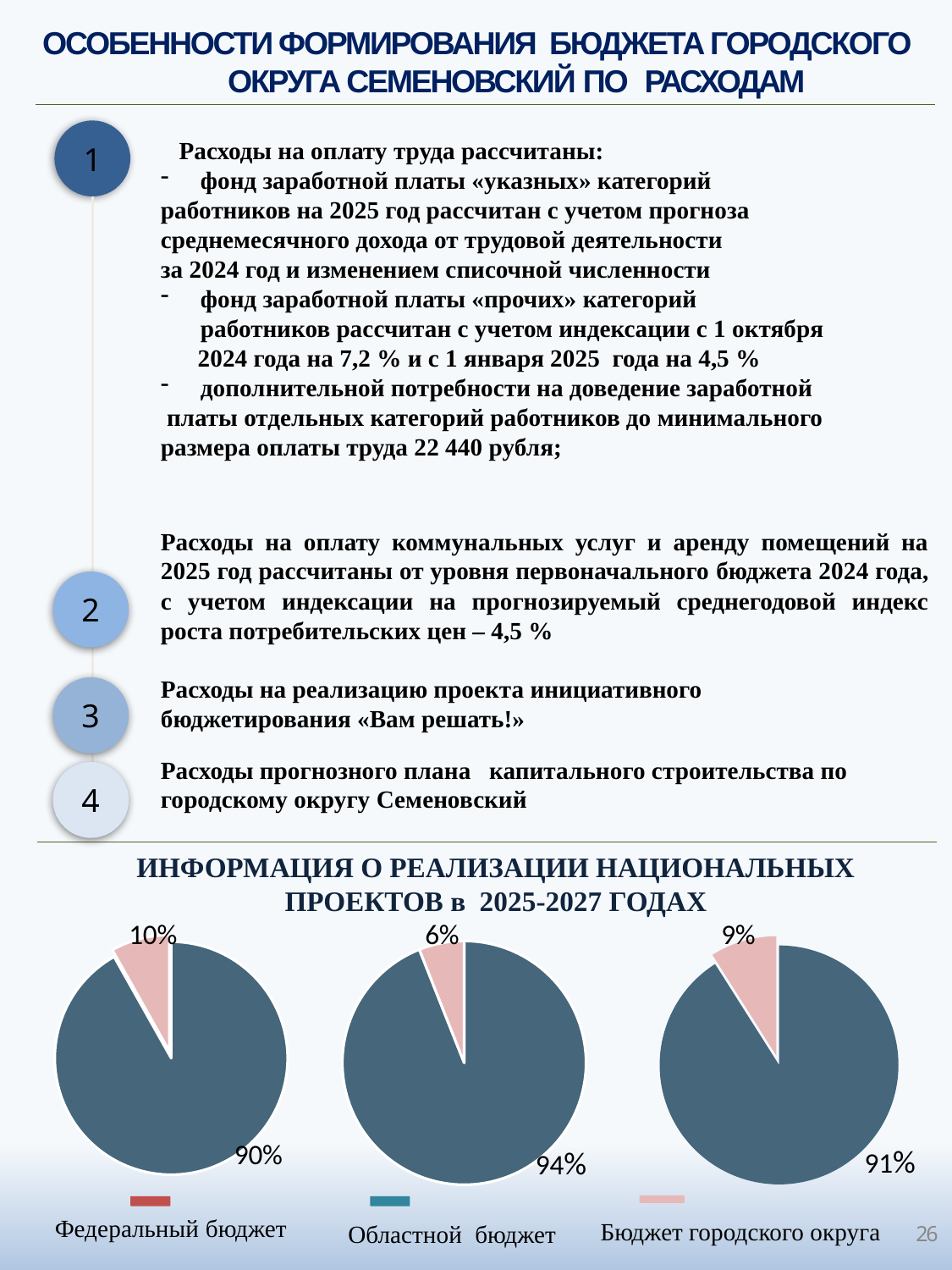
In the right pie chart, what is the value of the large dark slice? 91% How many pie charts are shown on the slide? 3 In the left pie chart, what is the value of the large dark slice? 90% What is the difference between the dark slice of the middle pie chart and the dark slice of the left pie chart? 4% In the left pie chart, what is the value of the small pink slice? 10% In the middle pie chart, what is the value of the small pink slice? 6% In the middle pie chart, what is the value of the large dark slice? 94% Which of the three pie charts has the largest pink slice? The left pie chart (10%) In the right pie chart, what is the value of the small pink slice? 9% Which of the three pie charts has the smallest pink slice? The middle pie chart (6%) What kind of charts are shown at the bottom of the slide? Pie charts How many entries does the legend below the pie charts list? 3